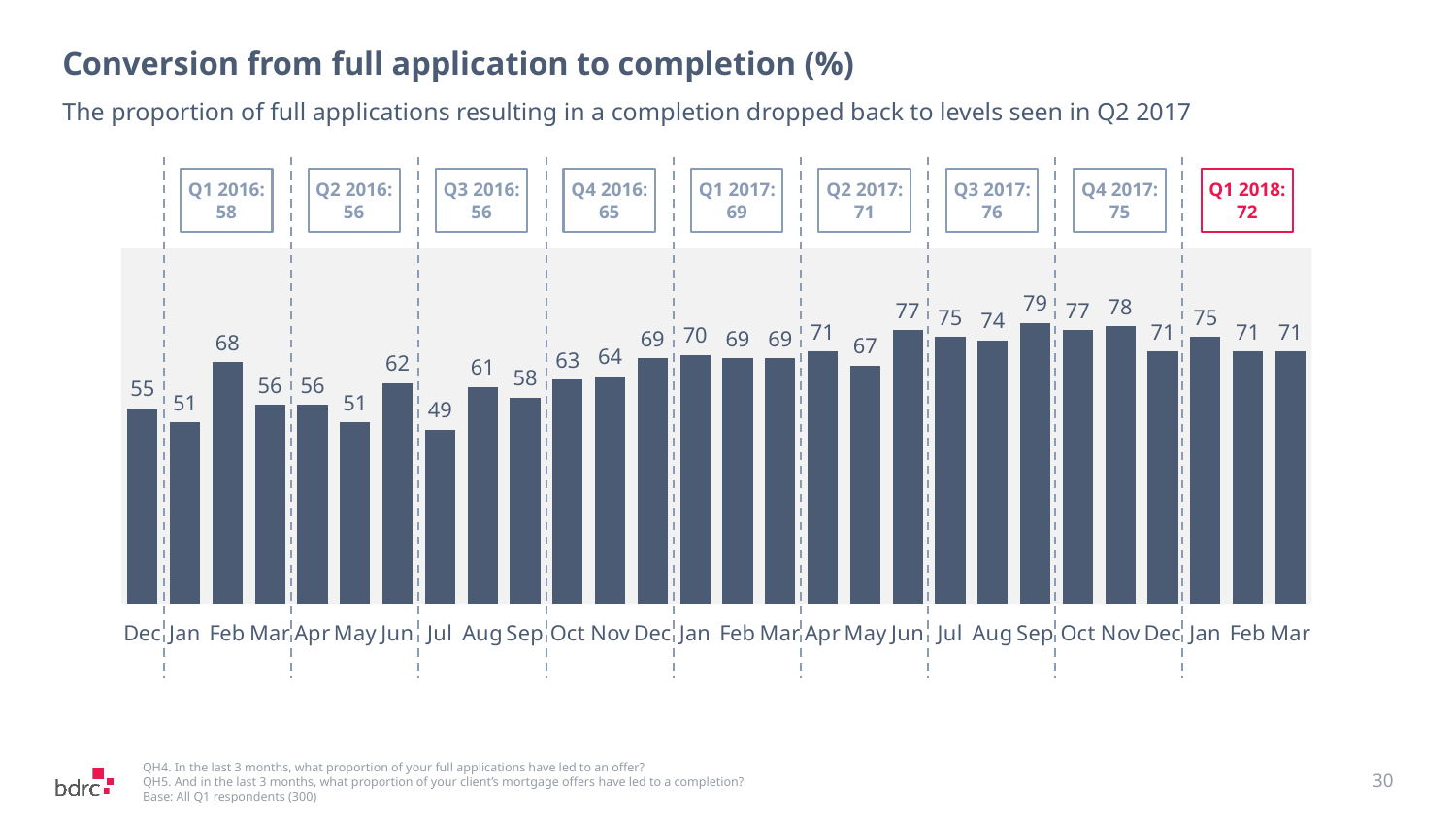
Which month has the lowest conversion value in the chart? Jul (2016), 49 What is the quarterly value shown in the box for Q3 2017? 76 How many monthly bars are plotted in the chart? 28 How many quarterly summary boxes are shown above the chart? 9 What is the difference between the highest monthly value (Sep 2017) and the lowest monthly value (Jul 2016)? 30 What type of chart is shown on the slide? bar chart What is the conversion value for Feb 2016 (the Feb bar within Q1 2016)? 68 Which quarterly box is highlighted in red? Q1 2018: 72 Which month has the highest conversion value in the chart? Sep (2017), 79 What is the difference between the Q1 2018 quarterly value and the Q4 2017 quarterly value? 3 Which is larger: the value for Jun 2017 or the value for Jun 2016? Jun 2017 (77) What is the conversion value for Mar 2018 (the last bar)? 71